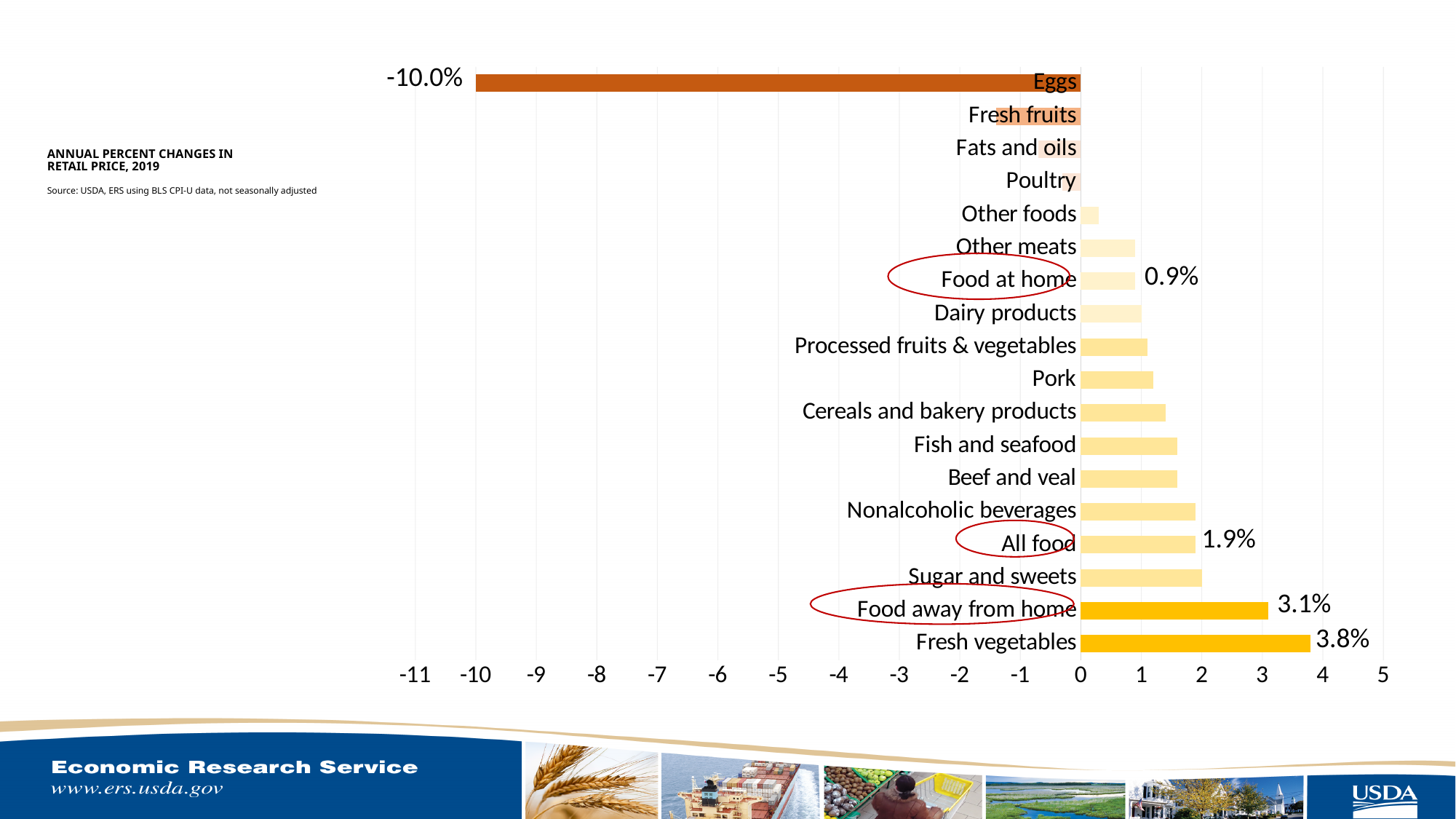
What is the difference in percentage points between Fresh vegetables and Food away from home? 0.7 Which is larger, the percent change for Food away from home or for Food at home? Food away from home How many categories are shown in the chart? 18 Which category has the lowest annual percent change in retail price? Eggs What is the annual percent change in retail price for Food away from home? 3.1% What is the annual percent change in retail price for Fresh vegetables? 3.8% Is the value for Pork greater or less than 1? greater What is the annual percent change in retail price for All food? 1.9% What is the annual percent change in retail price for Eggs? -10.0% What kind of chart is shown on the slide? Bar chart Which category has the highest annual percent change in retail price? Fresh vegetables What is the annual percent change in retail price for Food at home? 0.9%